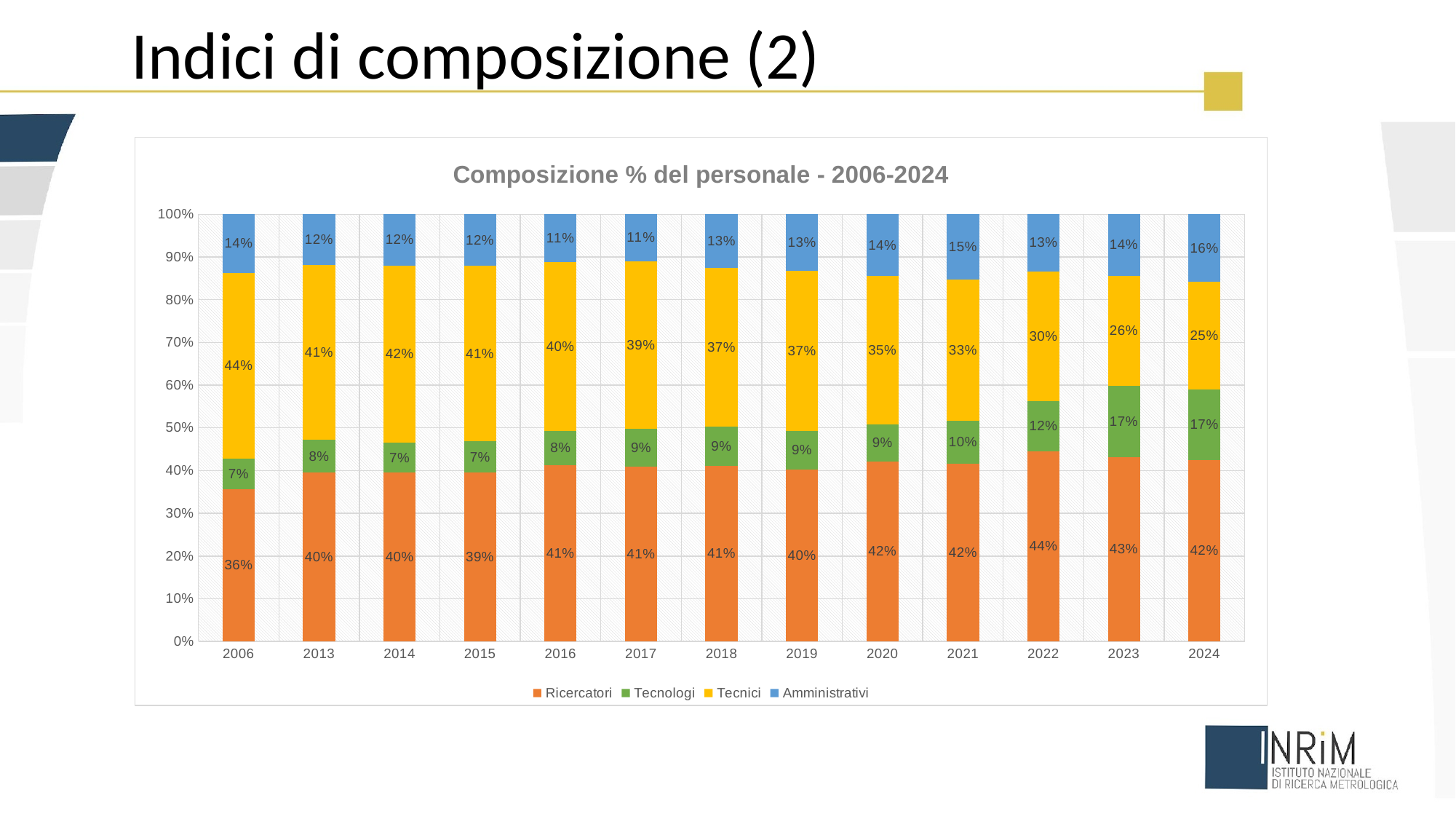
Which is larger in 2021: the Ricercatori share or the Tecnici share? Ricercatori What is the Ricercatori share in 2022? 44% In which year is the Tecnici share lowest? 2024 In which year is the Ricercatori share lowest? 2006 What kind of chart is shown? Stacked bar chart Does the Tecnici share rise or fall from 2016 to 2024? Fall What is the Tecnici share in 2006? 44% How many years are shown on the x axis? 13 What is the Amministrativi share in 2024? 16% What is the Tecnologi share in 2023? 17% What is the difference between the Tecnici share in 2006 and in 2024? 19% How many series does the legend list? 4